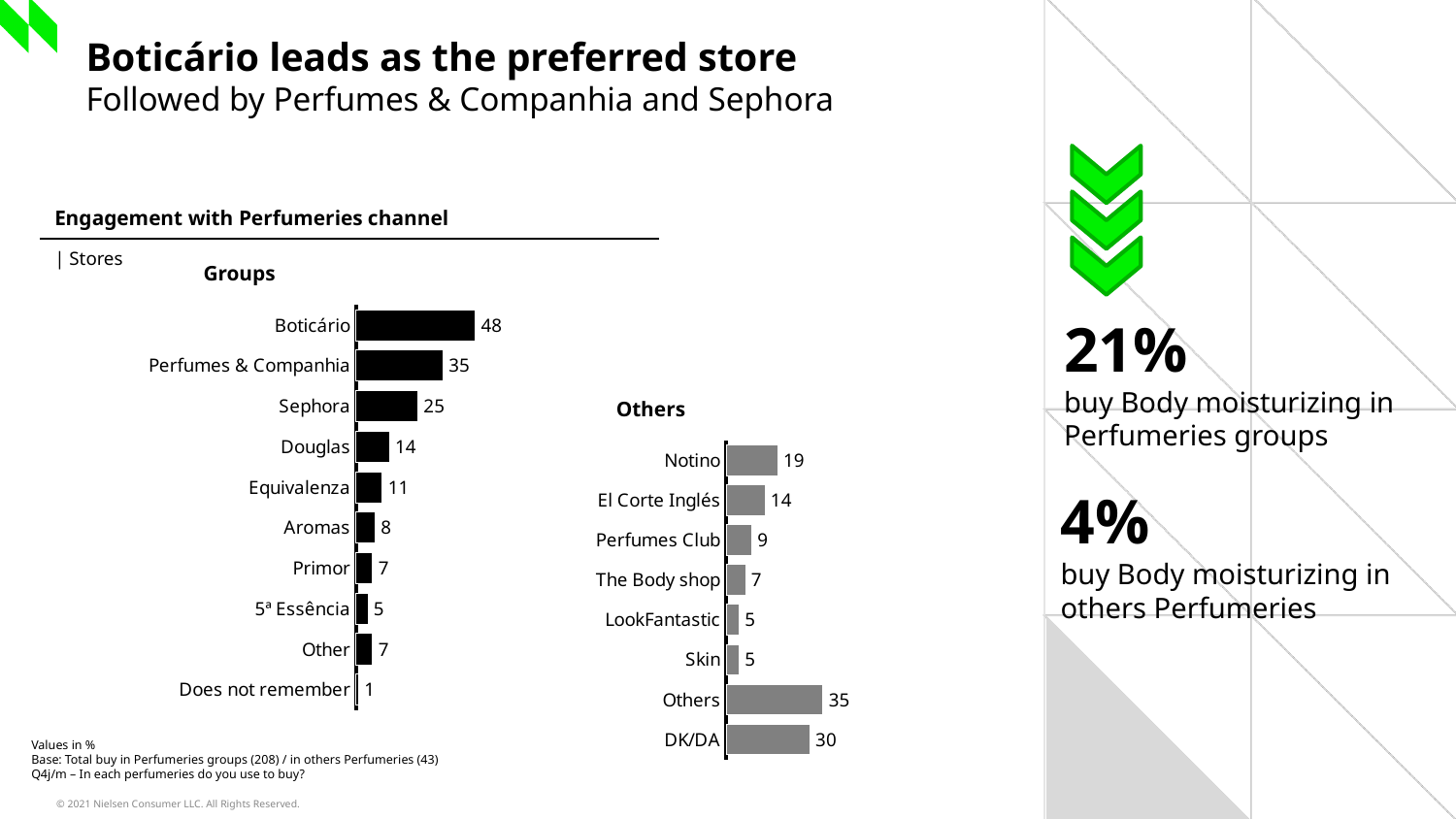
What type of chart is the Groups chart? Bar chart In the Others chart, what is the value for El Corte Inglés? 14 In the Groups chart, what is the value for Sephora? 25 In the Others chart, what is the difference between Notino and Perfumes Club? 10 In the Groups chart, which category has the lowest value? Does not remember In the Others chart, what is the value for DK/DA? 30 In the Groups chart, what is the difference between Boticário and Perfumes & Companhia? 13 In the Groups chart, which store has the highest value? Boticário In the Others chart, which category has the highest value? Others In the Groups chart, what is the value for Boticário? 48 How many categories are shown in the Others chart? 8 In the Groups chart, which is larger: Douglas or Equivalenza? Douglas